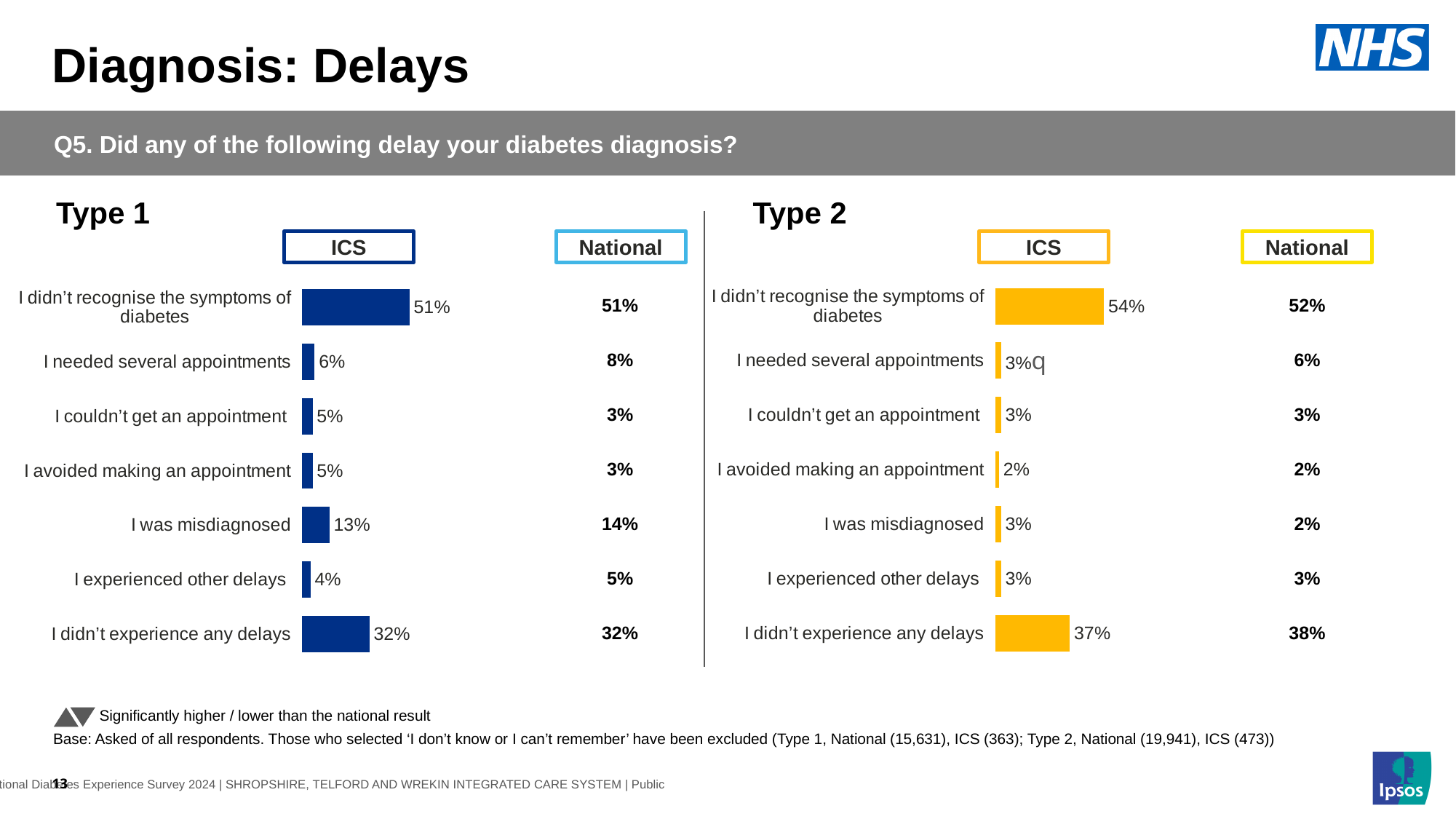
What kind of chart is used for the ICS values in the Type 1 chart? Bar chart In the Type 2 chart, what is the difference between the ICS and National values for 'I needed several appointments'? 3% In the Type 2 chart, what is the National value for 'I didn't recognise the symptoms of diabetes'? 52% In the Type 1 chart, what is the difference between the ICS values for 'I didn't recognise the symptoms of diabetes' and 'I didn't experience any delays'? 19% What colour are the ICS bars in the Type 2 chart? Yellow In the Type 1 chart, which is larger: the ICS value for 'I was misdiagnosed' or the ICS value for 'I needed several appointments'? I was misdiagnosed In the Type 1 chart, which category has the highest ICS value? I didn't recognise the symptoms of diabetes In the Type 2 chart, which category has the lowest ICS value? I avoided making an appointment How many categories are shown in the Type 2 chart? 7 In the Type 1 chart, what is the ICS value for 'I didn't recognise the symptoms of diabetes'? 51% In the Type 2 chart, what is the ICS value for 'I didn't experience any delays'? 37% In the Type 1 chart, what is the National value for 'I was misdiagnosed'? 14%